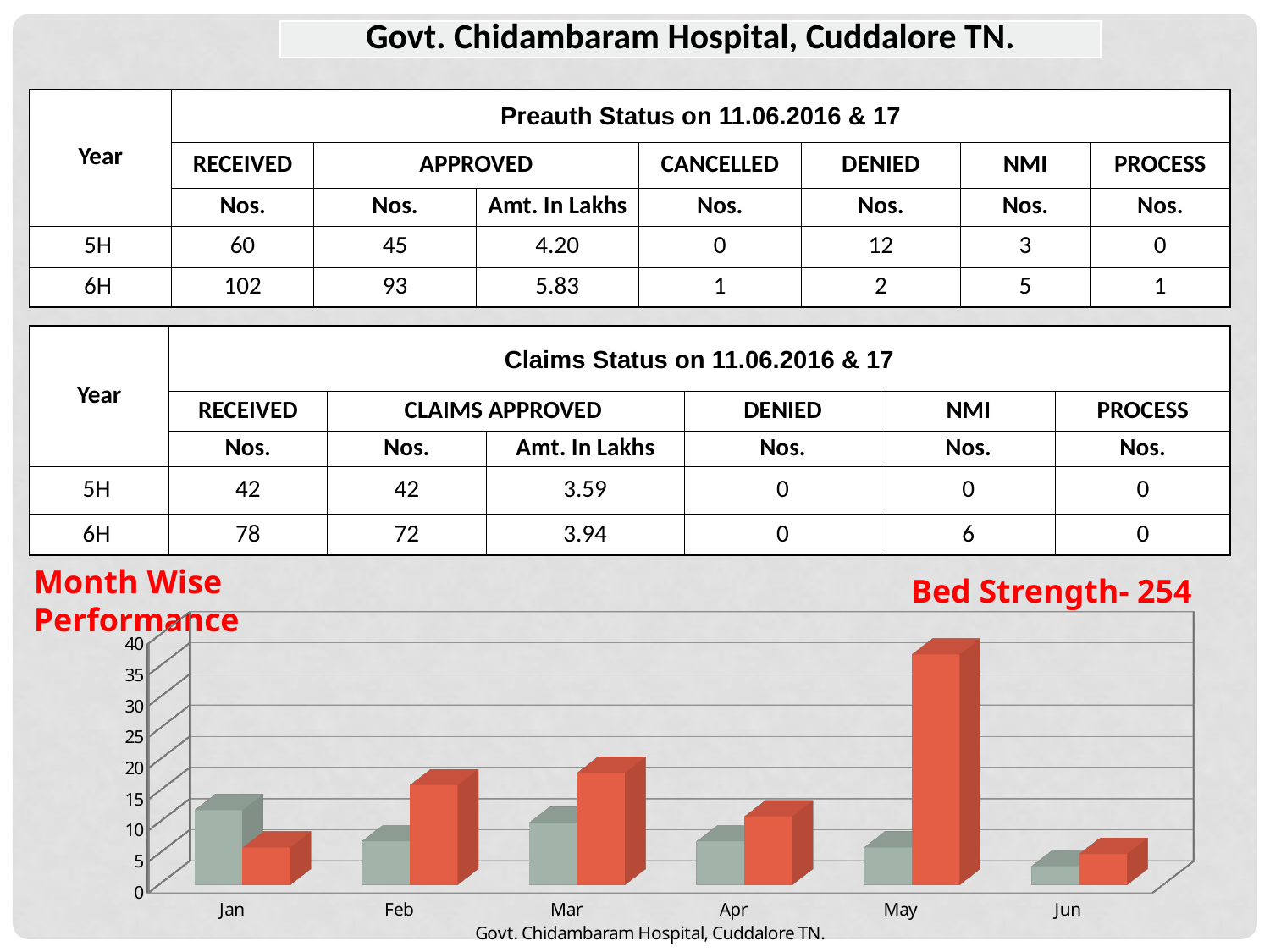
In the Month Wise Performance chart, which bar is taller for Feb, the grey bar or the red bar? the red bar How many months are shown on the x axis of the Month Wise Performance chart? 6 In the Month Wise Performance chart, which month has the shortest grey bar? Jun What is the highest value shown on the y axis of the Month Wise Performance chart? 40 In the Month Wise Performance chart, which bar is taller for Jan, the grey bar or the red bar? the grey bar In the Month Wise Performance chart, is the red bar for May greater or less than 30? greater In the Month Wise Performance chart, is the red bar for Feb greater or less than 20? less In the Month Wise Performance chart, is the red bar for May taller or shorter than the red bar for Mar? taller In the Month Wise Performance chart, is the grey bar for Jan greater or less than 5? greater What kind of chart is shown under the heading 'Month Wise Performance'? bar chart In the Month Wise Performance chart, do the red bars rise or fall from Jan to Mar? rise In the Month Wise Performance chart, which month has the tallest red bar? May